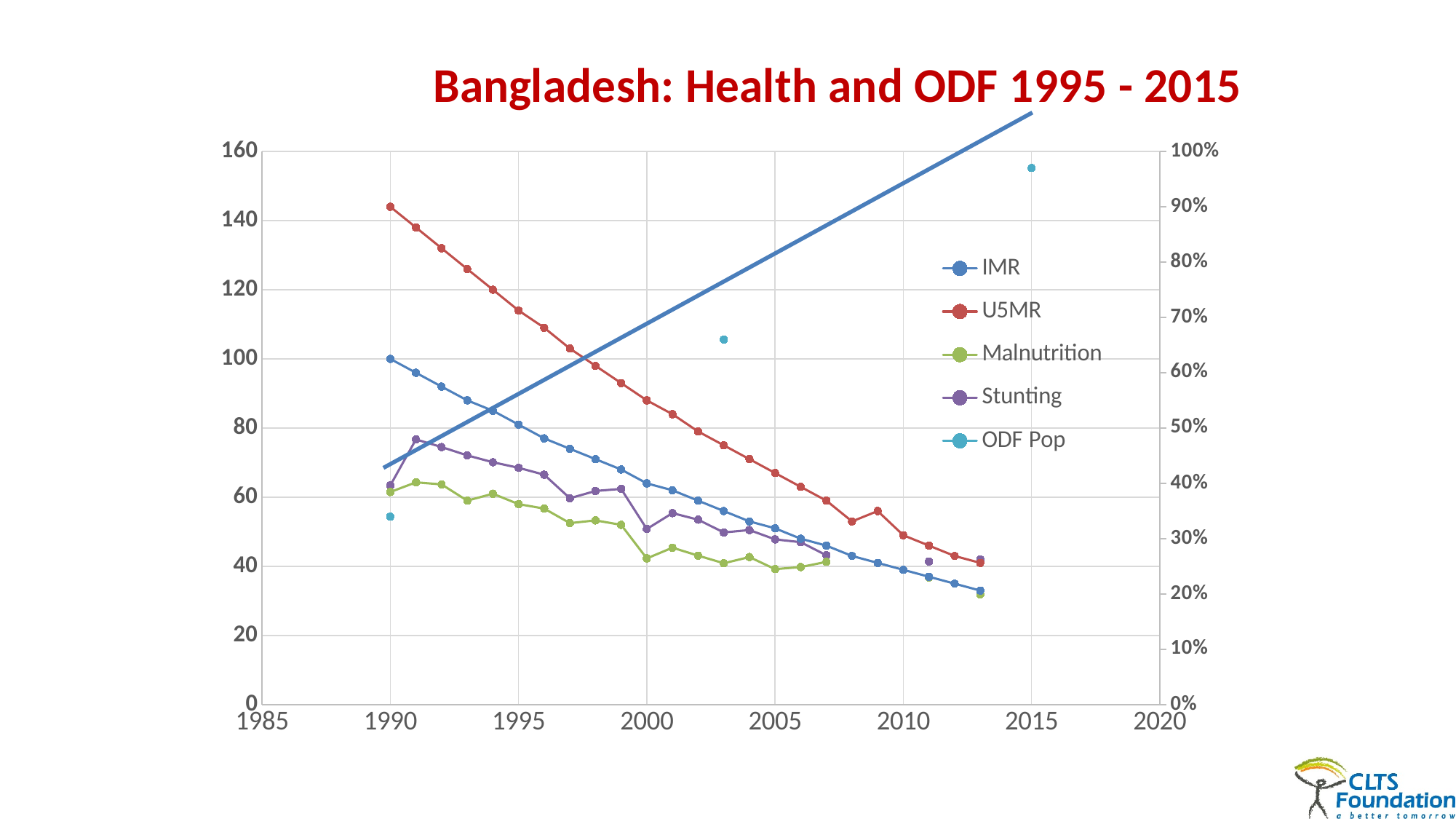
Does the U5MR series rise or fall from 1990 to 2013? fall How many series does the legend list? 5 Is the ODF Pop value for 1990 greater or less than 40%? less Is the IMR value for 2013 greater or less than 40? less What is the title of the chart? Bangladesh: Health and ODF 1995 - 2015 Is the ODF Pop value for 2015 greater or less than 90%? greater What kind of chart is shown on the slide? line chart How many ODF Pop data points are plotted? 3 Does the IMR series rise or fall along the x axis? fall Which series is drawn in red? U5MR In 1990, which is larger, the U5MR value or the IMR value? U5MR